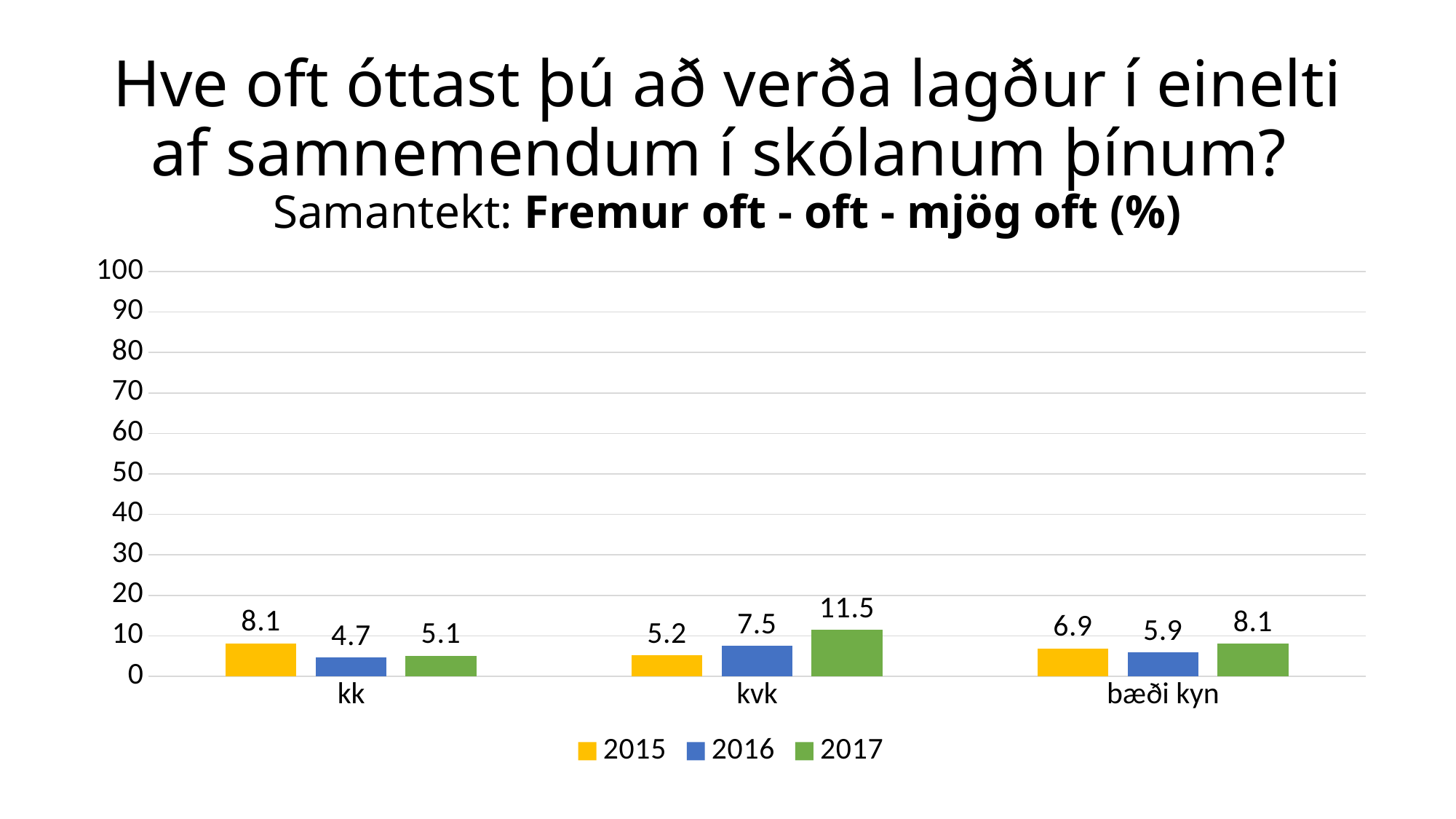
Which category has the highest value for the 2017 series? kvk What is the value for 2017 in the kvk category? 11.5 Which colour represents the 2016 series in the legend? blue What is the value for 2016 in the bæði kyn category? 5.9 What kind of chart is shown on the slide? bar chart What is the value for 2015 in the kk category? 8.1 Which is larger in the kk category: the 2015 value or the 2016 value? 2015 Is the value for 2017 in the kvk category greater or less than 10? greater How many series does the legend list? 3 How many categories are shown on the x axis? 3 What is the difference between the 2017 and 2015 values in the kvk category? 6.3 Which category has the lowest value for the 2016 series? kk